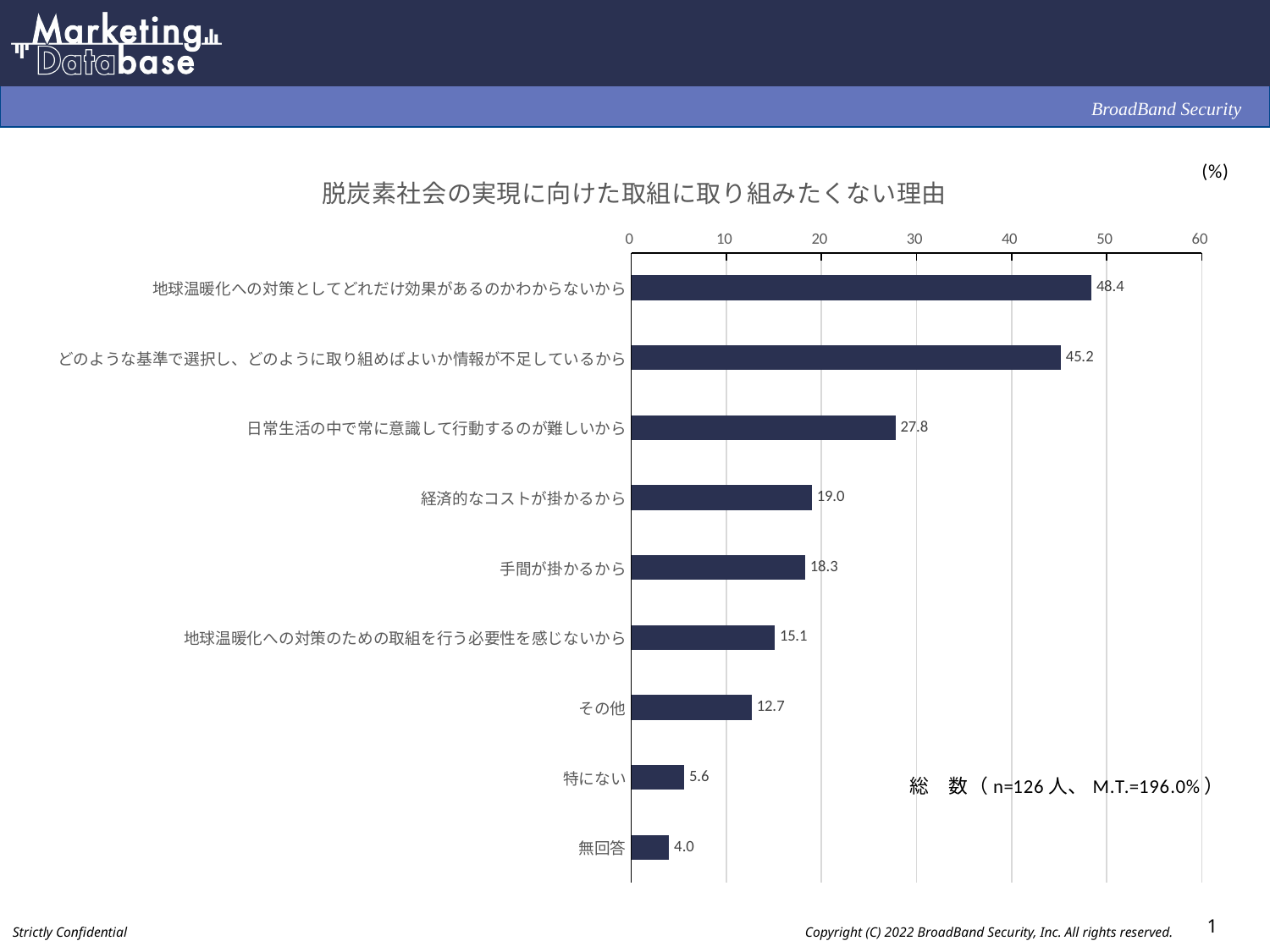
What is the title of the chart? 脱炭素社会の実現に向けた取組に取り組みたくない理由 What is the value for 経済的なコストが掛かるから? 19.0 What is the value for 無回答? 4.0 What is the difference between the values for 地球温暖化への対策としてどれだけ効果があるのかわからないから and どのような基準で選択し、どのように取り組めばよいか情報が不足しているから? 3.2 What is the sample size (n) shown on the slide? 126 What kind of chart is shown on the slide? bar chart How many categories are shown in the chart? 9 Which category has the highest value? 地球温暖化への対策としてどれだけ効果があるのかわからないから Which is larger, the value for 日常生活の中で常に意識して行動するのが難しいから or the value for 手間が掛かるから? 日常生活の中で常に意識して行動するのが難しいから Is the value for その他 greater or less than 10? greater What is the value for 地球温暖化への対策としてどれだけ効果があるのかわからないから? 48.4 Which category has the lowest value? 無回答